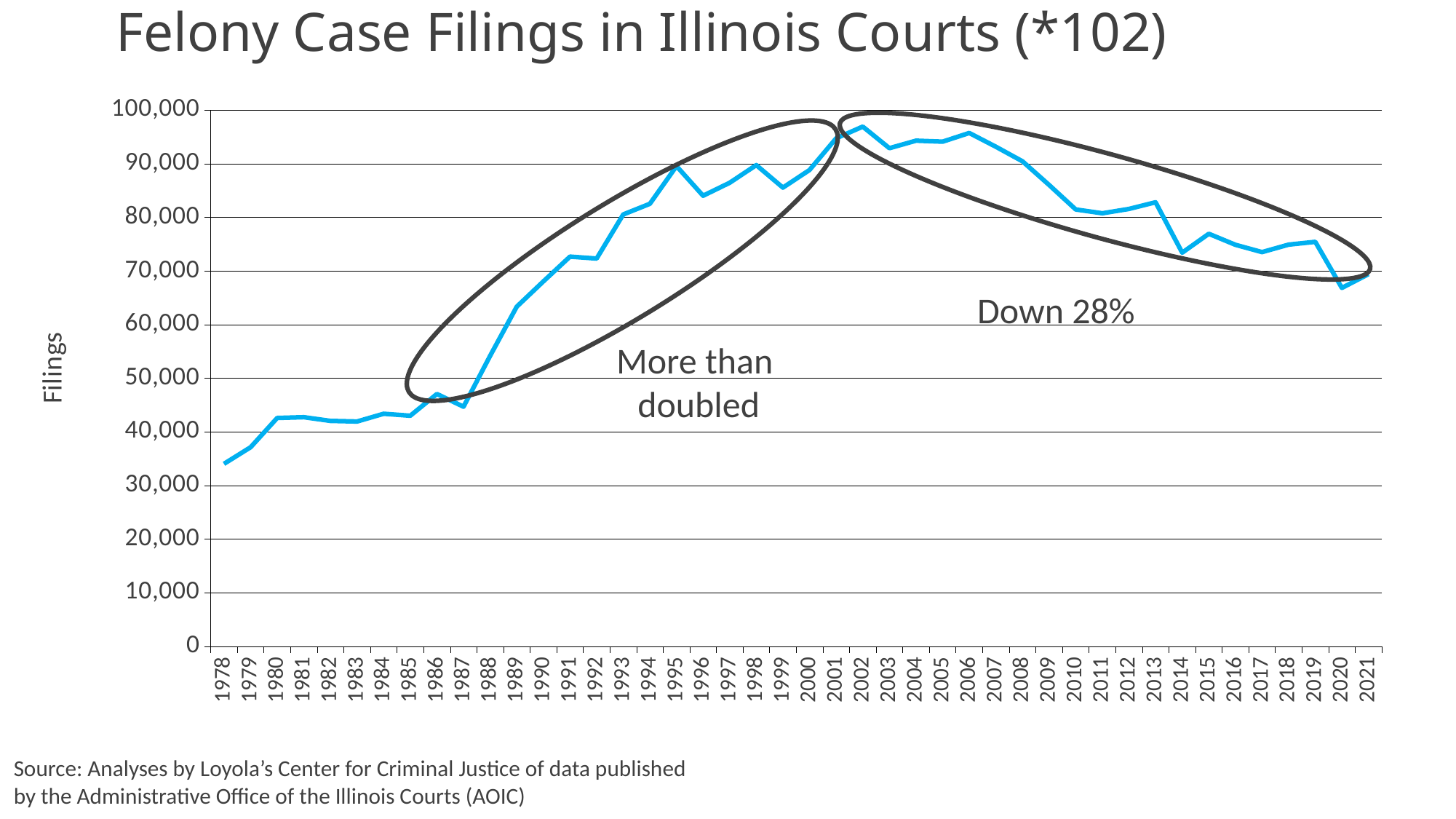
Is the value for 2020 greater or less than 70,000? less Is the value for 1978 greater or less than 40,000? less Is the value for 1987 greater or less than 50,000? less What kind of chart is shown on the slide? line chart Do filings rise or fall between 1978 and 2001? rise How many years are shown on the x axis? 44 What is the title of the chart? Felony Case Filings in Illinois Courts (*102) Do filings rise or fall between 2006 and 2021? fall What is the label on the vertical axis? Filings Which year has the lowest number of filings? 1978